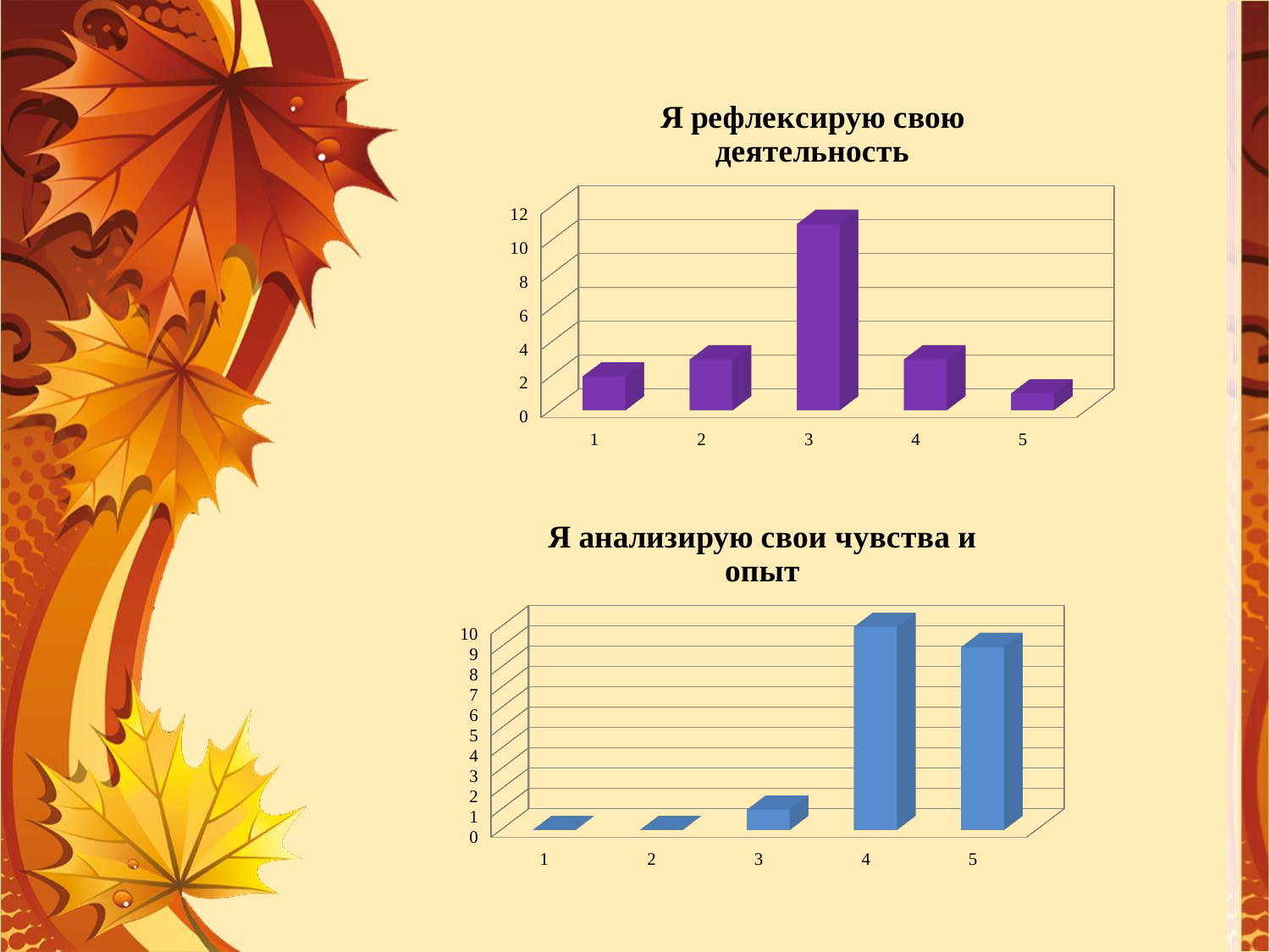
In the chart titled "Я рефлексирую свою деятельность", is the value for category 5 greater or less than 2? less In the chart titled "Я рефлексирую свою деятельность", which category has the lowest value? 5 In the chart titled "Я анализирую свои чувства и опыт", which category has the highest value? 4 In the chart titled "Я анализирую свои чувства и опыт", is the value for category 5 greater or less than 5? greater In the chart titled "Я анализирую свои чувства и опыт", which is larger, the value for category 4 or the value for category 3? category 4 In the chart titled "Я рефлексирую свою деятельность", which is larger, the value for category 3 or the value for category 1? category 3 In the chart titled "Я рефлексирую свою деятельность", which category has the highest value? 3 What is the title of the bottom chart on the slide? Я анализирую свои чувства и опыт In the chart titled "Я анализирую свои чувства и опыт", is the value for category 3 greater or less than 3? less What kind of chart is the top chart on the slide? bar chart How many categories are shown on the x axis of the chart titled "Я рефлексирую свою деятельность"? 5